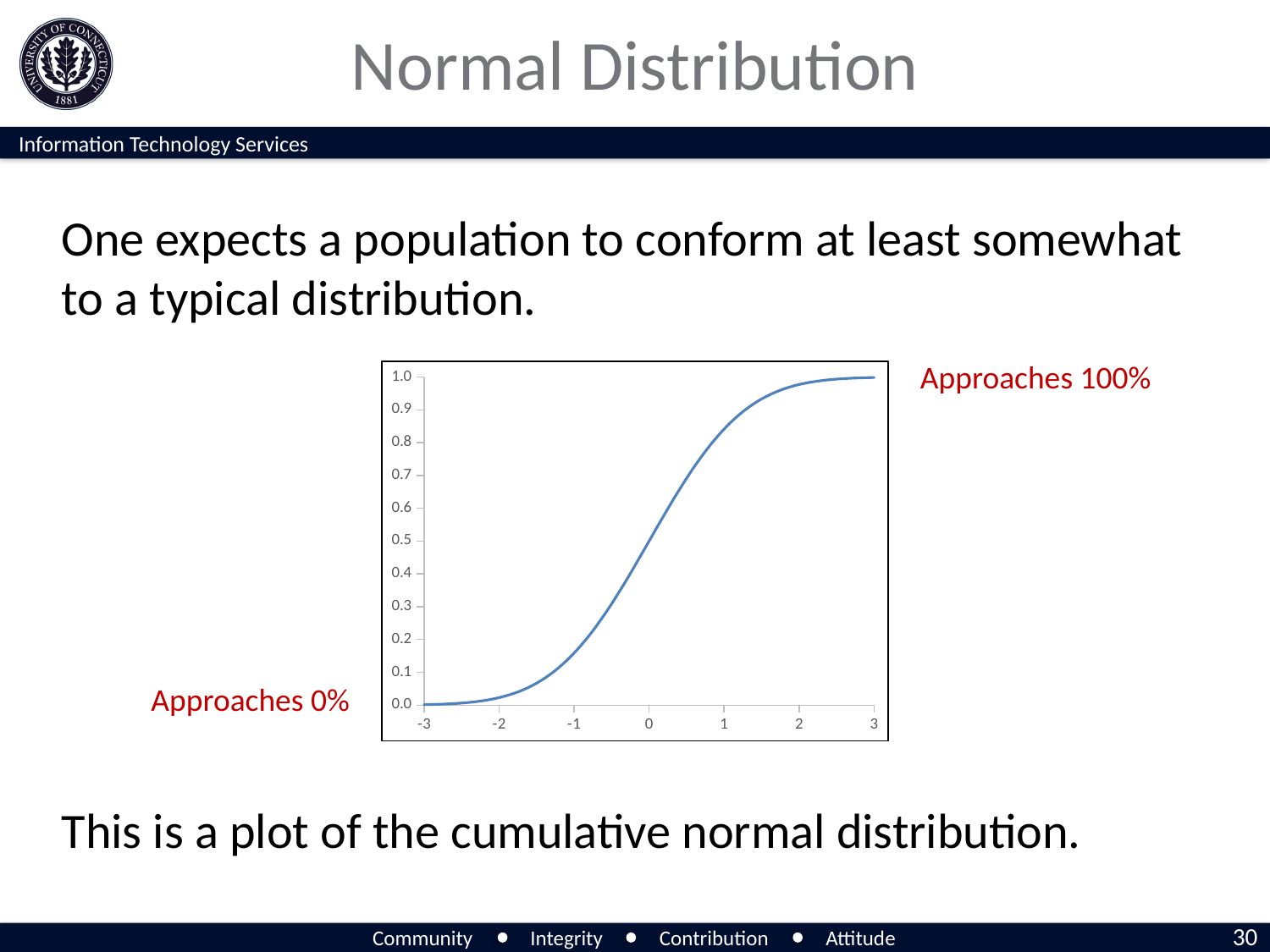
What is the highest value labelled on the y axis? 1.0 Is the value of the curve at x = 2 greater or less than 0.9? greater Is the value of the curve at x = 1 greater or less than 0.5? greater What kind of chart is shown on the slide? line chart Is the value of the curve at x = -1 greater or less than 0.5? less What colour is the plotted line on the chart? blue Do the values on the chart rise or fall as x increases from -3 to 3? rise At which labelled x value is the curve highest? 3 At which labelled x value is the curve lowest? -3 How many labelled tick values are on the x axis? 7